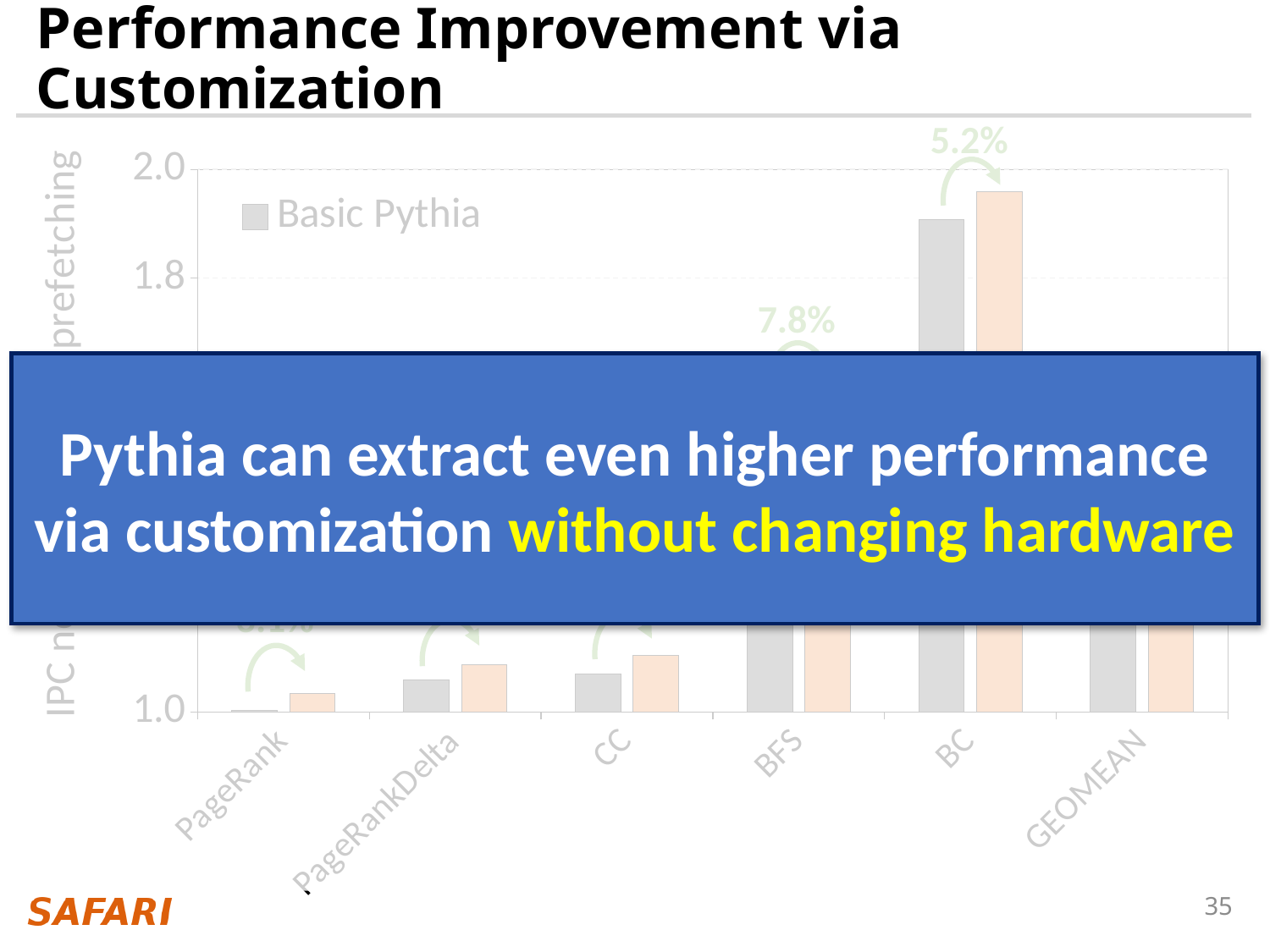
What kind of chart is shown on the slide? bar chart What is the highest value shown on the chart's y axis? 2.0 Is the value of the Basic Pythia bar for BC greater or less than 1.8? greater For BC, which bar is taller: the grey Basic Pythia bar or the orange bar? the orange bar What percentage improvement is labelled above the BC bars? 5.2% How many categories are shown along the x axis of the chart? 6 Which category has the tallest bars in the chart? BC Is the value of the orange bar for BC greater or less than 2.0? less What is the series name shown in the chart's legend? Basic Pythia For PageRank, which bar is taller: the grey Basic Pythia bar or the orange bar? the orange bar What percentage improvement is labelled above the BFS bars? 7.8% Which category has the shortest grey (Basic Pythia) bar in the chart? PageRank